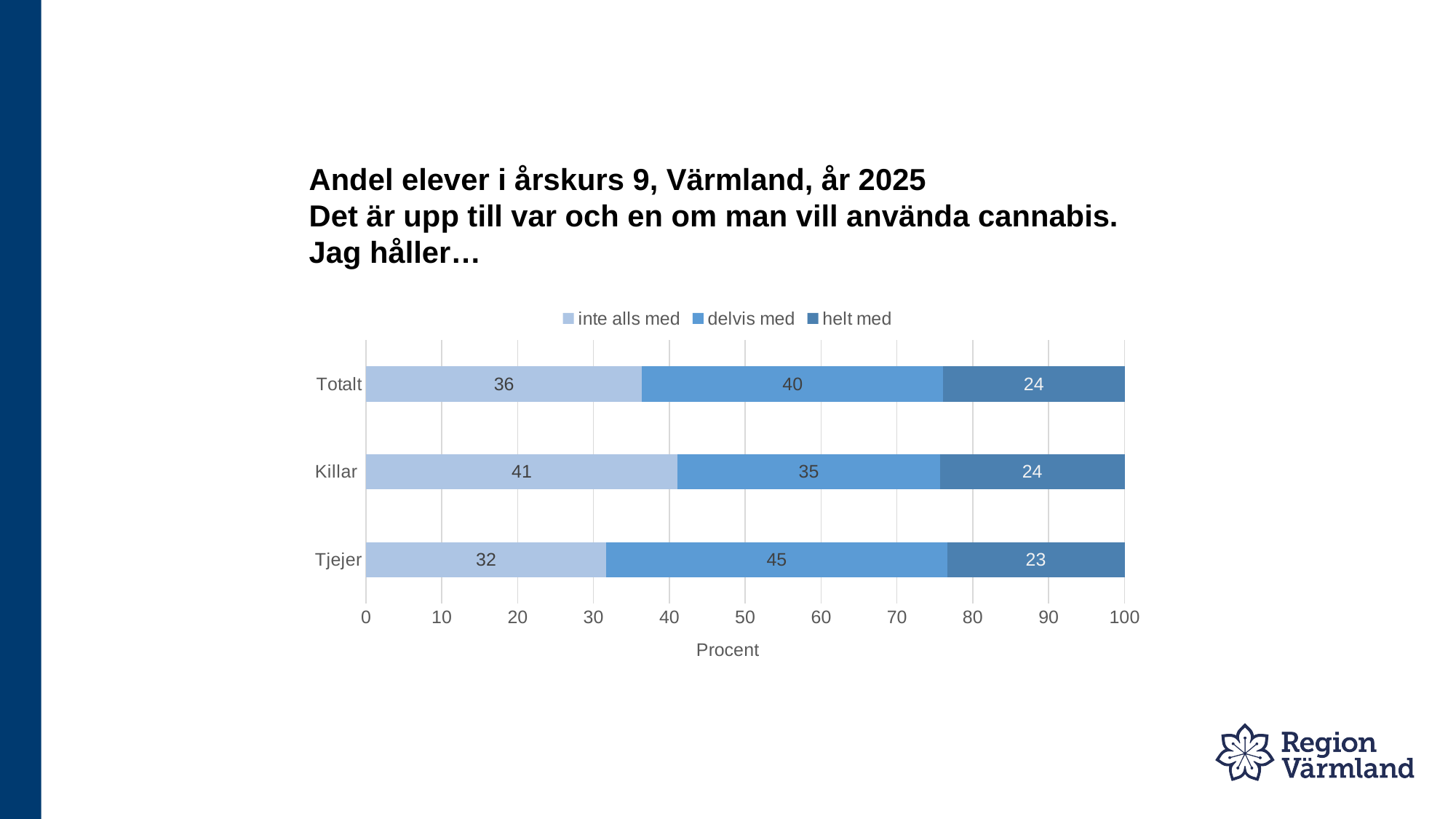
Which category has the lowest value for "delvis med"? Killar What is the value for "helt med" for Killar? 24 What is the total of the stacked bar for Totalt? 100 What is the value for "delvis med" for Tjejer? 45 How many series does the legend list? 3 Which is larger: "inte alls med" for Killar or "inte alls med" for Tjejer? Killar What is the difference between the "delvis med" values for Tjejer and Killar? 10 What is the label of the x axis? Procent How many categories are shown on the y axis? 3 Which category has the highest value for "inte alls med"? Killar What kind of chart is shown? Stacked bar chart What is the value for "inte alls med" for Totalt? 36